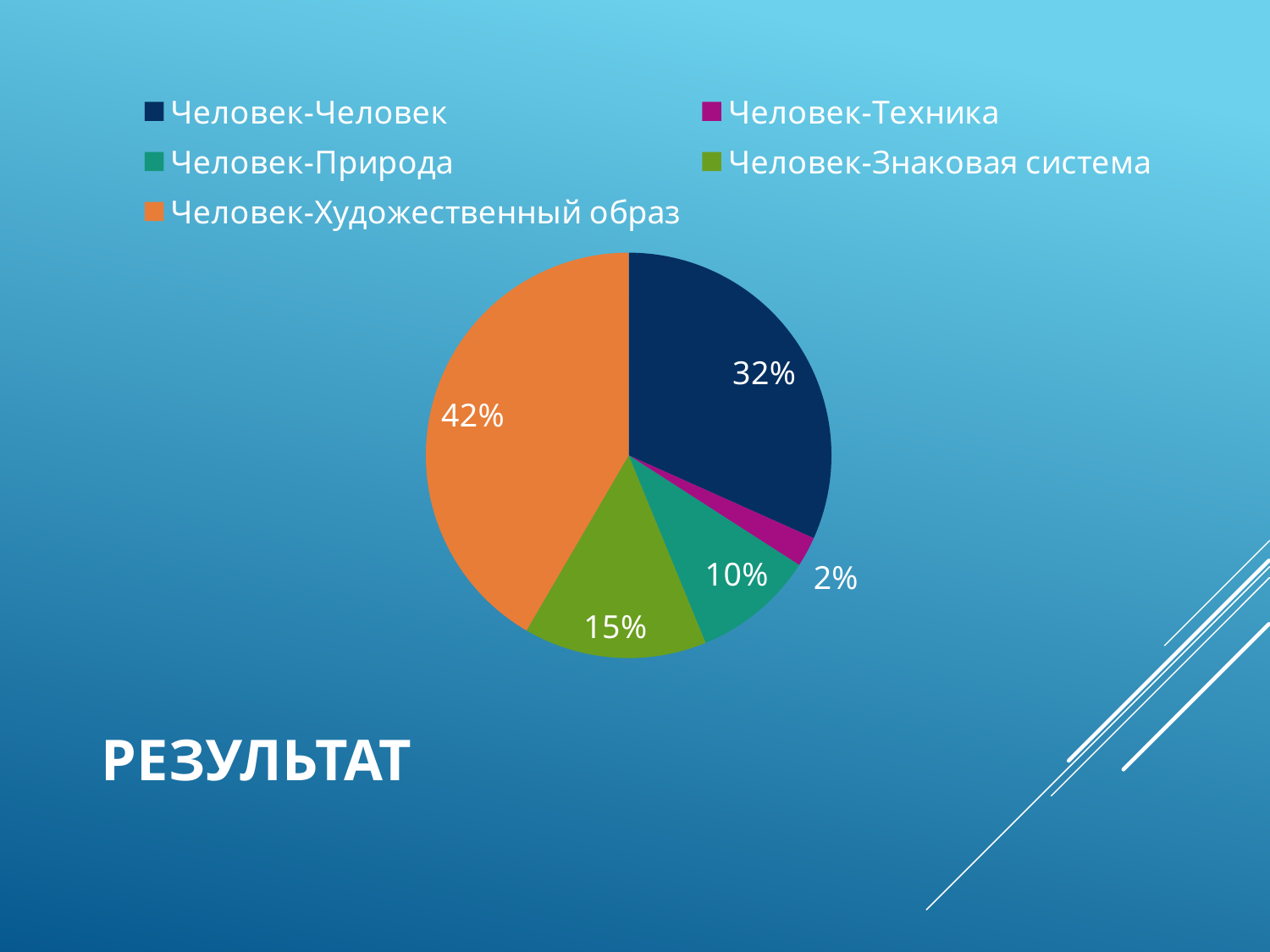
What is the value for Человек-Природа? 10% Which category has the largest slice of the pie? Человек-Художественный образ What is the value for Человек-Техника? 2% What colour is the slice for Человек-Человек? Dark blue How many categories does the pie chart have? 5 What share of the pie does Человек-Художественный образ have? 42% Which category has the smallest slice of the pie? Человек-Техника What is the difference between the values for Человек-Художественный образ and Человек-Человек? 10% What is the value for Человек-Знаковая система? 15% What kind of chart is shown on the slide? Pie chart Which is larger, the value for Человек-Знаковая система or the value for Человек-Природа? Человек-Знаковая система What is the value for Человек-Человек? 32%